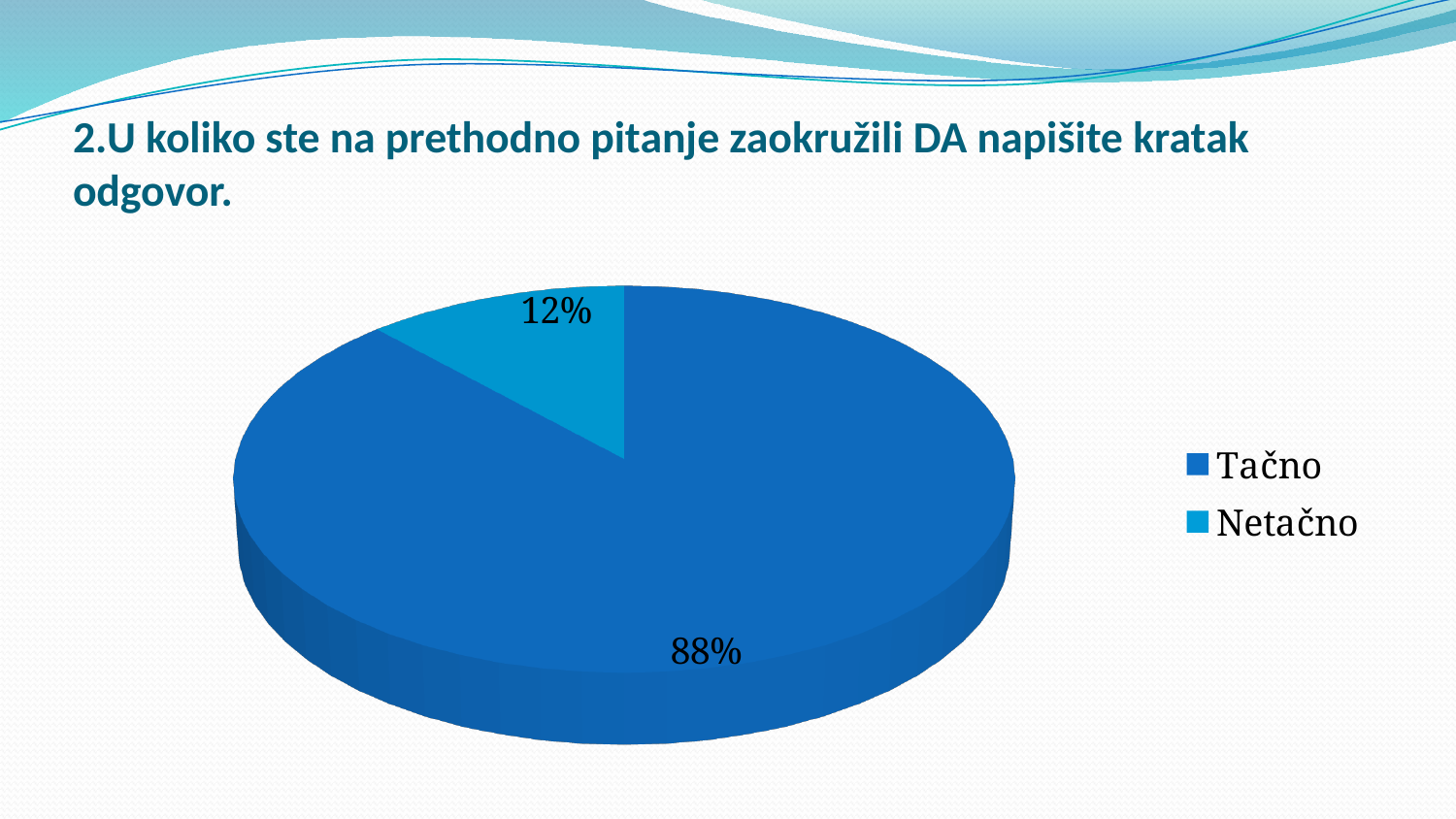
How many entries does the legend list? 2 Is the value for Tačno greater or less than 50%? greater Where is the legend positioned relative to the pie? to the right What is the difference in percentage points between the Tačno and Netačno slices? 76 Which category has the largest slice of the pie? Tačno How many categories does the pie chart show? 2 What colour is the Netačno slice? light blue What share of the pie does Netačno represent? 12% Which is larger, the Tačno slice or the Netačno slice? Tačno Which category has the smallest slice of the pie? Netačno What kind of chart is shown on the slide? pie chart What share of the pie does Tačno represent? 88%